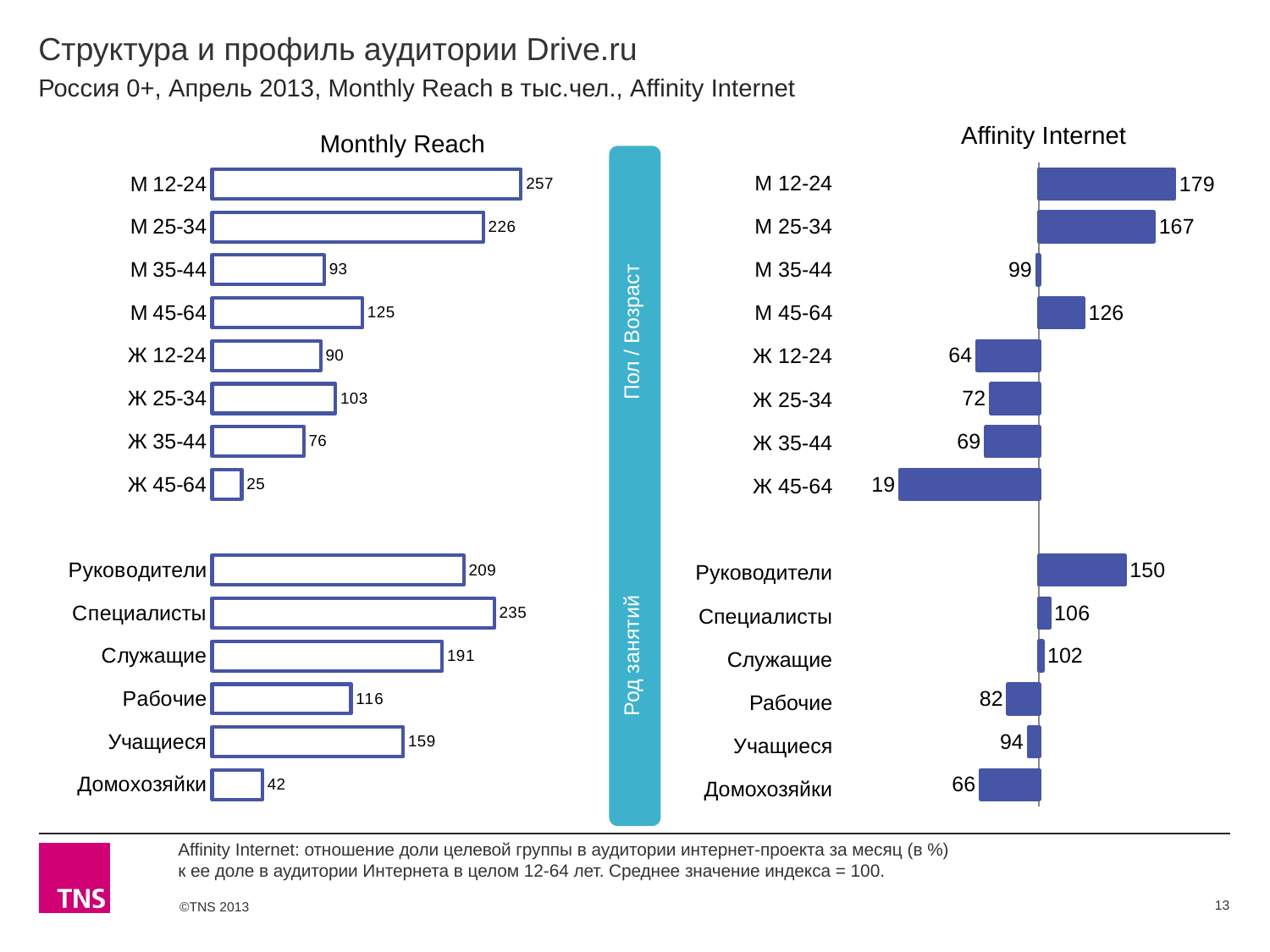
In the Monthly Reach chart, how many categories are plotted? 14 In the Affinity Internet chart, which is larger: М 25-34 or М 45-64? М 25-34 What type of chart is the Affinity Internet chart? Bar chart What are the two group labels shown on the vertical band between the charts? Пол / Возраст and Род занятий In the Affinity Internet chart, what is the value for Ж 45-64? 19 In the Monthly Reach chart, what is the difference between Специалисты and Руководители? 26 In the Affinity Internet chart, what is the difference between М 12-24 and М 25-34? 12 In the Monthly Reach chart, what is the value for Домохозяйки? 42 In the Monthly Reach chart, which category has the highest value? М 12-24 In the Monthly Reach chart, what is the value for М 12-24? 257 In the Affinity Internet chart, which category has the lowest value? Ж 45-64 In the Affinity Internet chart, what is the value for Руководители? 150